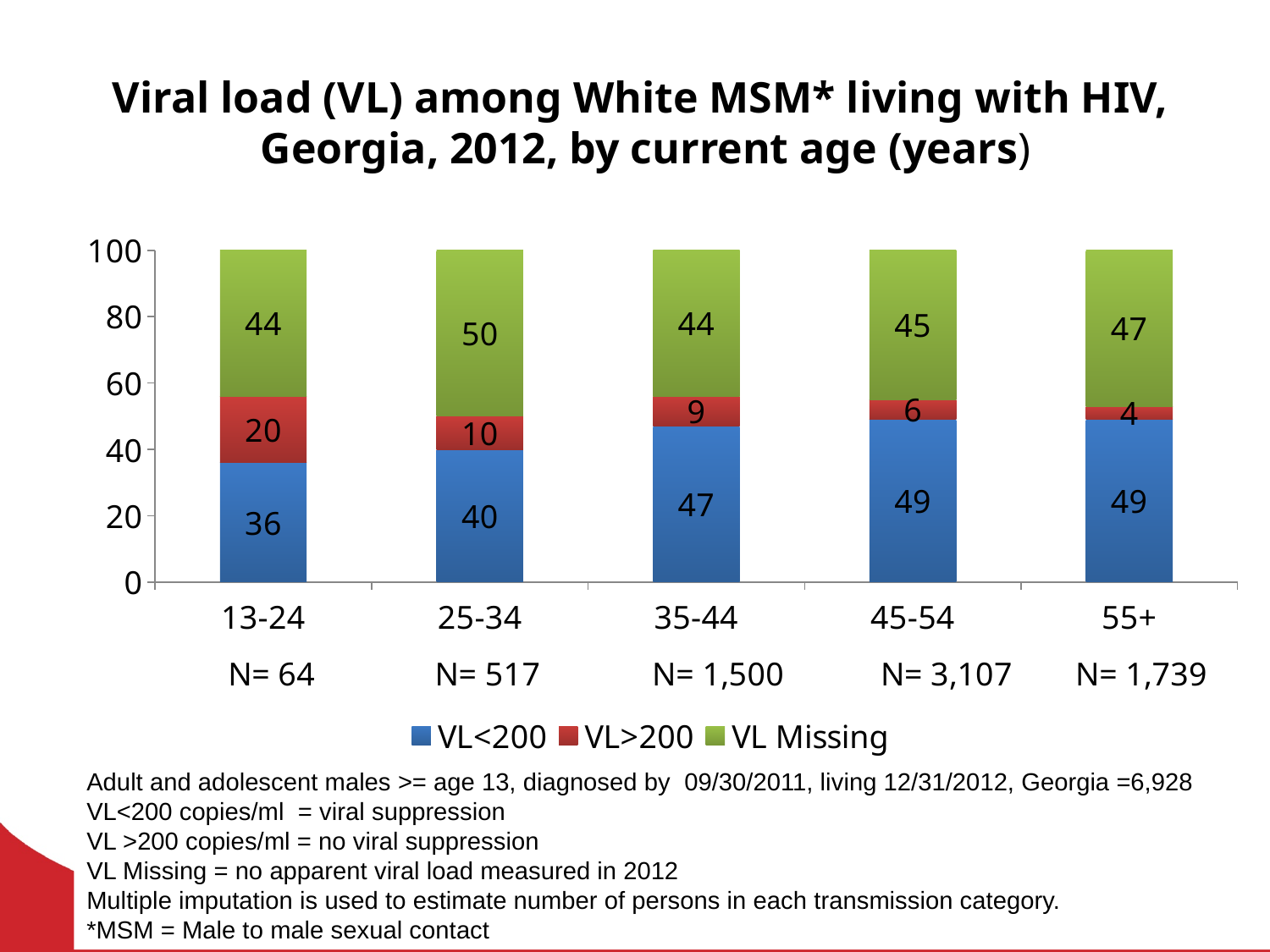
What is the VL Missing value for the 25-34 age group? 50 What is the difference between the VL<200 values for the 45-54 and 13-24 age groups? 13 How many age groups are shown on the x axis? 5 What is the N shown for the 45-54 age group? N= 3,107 How many series does the legend list? 3 What kind of chart is shown on the slide? Stacked bar chart What is the VL>200 value for the 55+ age group? 4 Do the VL>200 values rise or fall as age increases along the x axis? Fall What is the VL<200 value for the 13-24 age group? 36 Which is larger, the VL>200 value for 35-44 or for 45-54? 35-44 Which age group has the highest VL>200 value? 13-24 Which age group has the lowest VL<200 value? 13-24